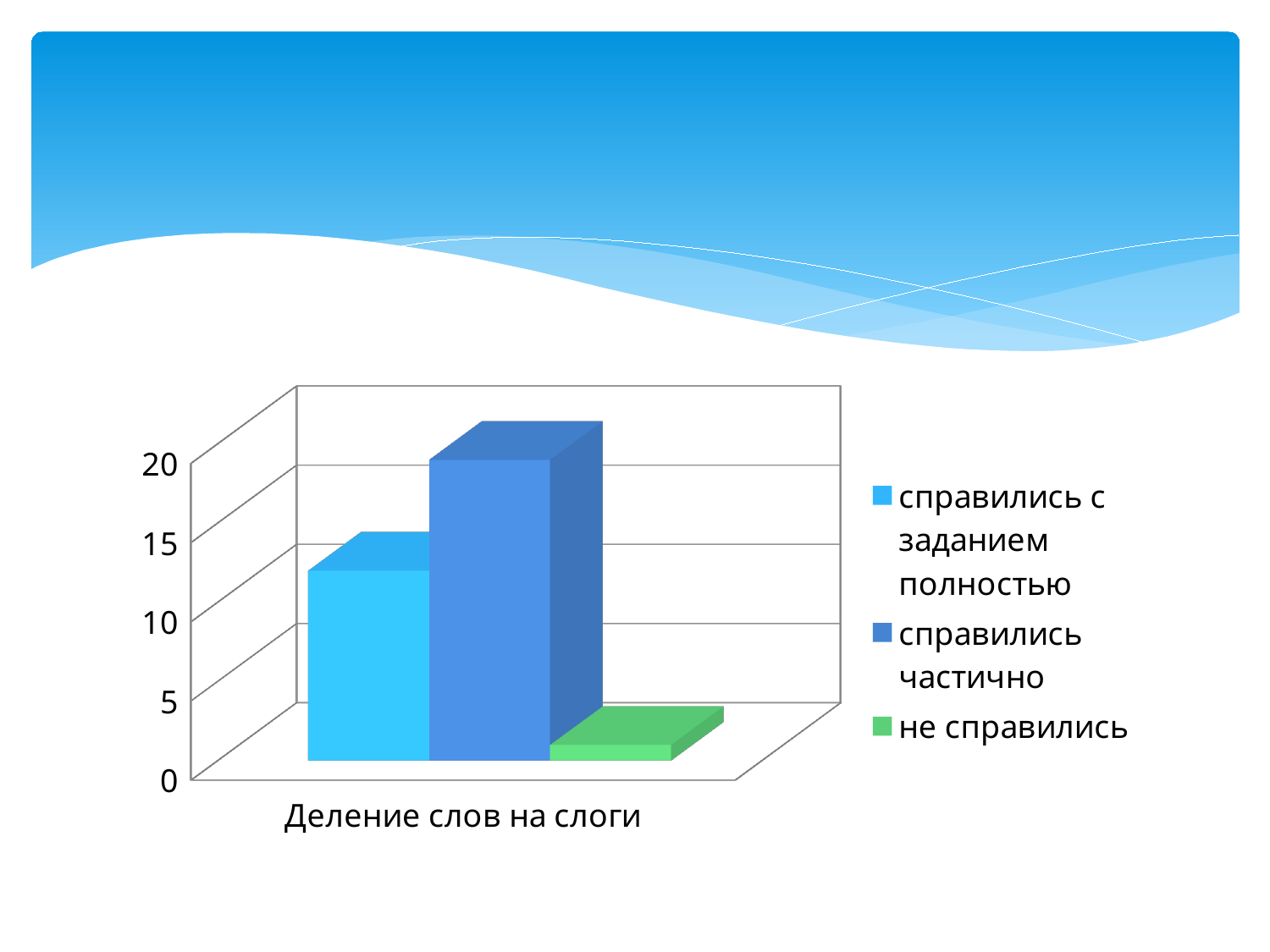
Which series has the lowest value? не справились Is the value for "не справились" greater or less than 5? less Which is larger: the value for "справились с заданием полностью" or the value for "не справились"? справились с заданием полностью What colour is the bar for "не справились"? green What is the category label on the x axis? Деление слов на слоги How many categories are shown on the x axis? 1 What kind of chart is shown on the slide? bar chart Which is larger: the value for "справились частично" or the value for "справились с заданием полностью"? справились частично Which series has the highest value? справились частично Is the value for "справились частично" greater or less than 15? greater Is the value for "справились с заданием полностью" greater or less than 10? greater How many series does the legend list? 3